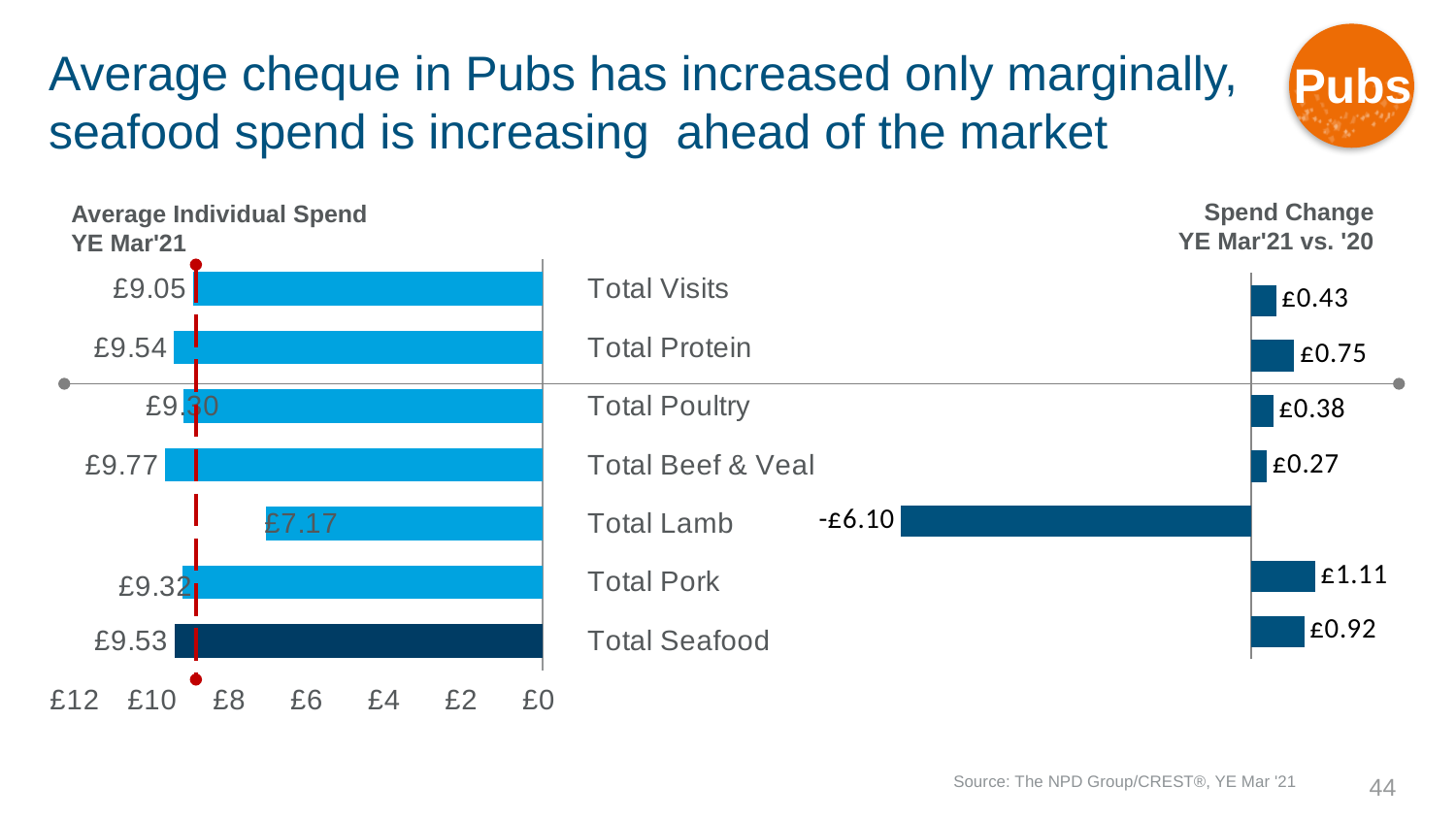
In the Spend Change YE Mar'21 vs. '20 chart, which category has the lowest value? Total Lamb How many categories are shown in the Average Individual Spend YE Mar'21 chart? 7 In the Average Individual Spend YE Mar'21 chart, which category has the lowest value? Total Lamb In the Spend Change YE Mar'21 vs. '20 chart, which is larger, Total Seafood or Total Protein? Total Seafood In the Average Individual Spend YE Mar'21 chart, what is the difference between Total Seafood and Total Visits? £0.48 In the Average Individual Spend YE Mar'21 chart, which category has the highest value? Total Beef & Veal In the Spend Change YE Mar'21 vs. '20 chart, what is the value for Total Pork? £1.11 What kind of chart is the Spend Change YE Mar'21 vs. '20 chart? Bar chart In the Average Individual Spend YE Mar'21 chart, what is the value for Total Lamb? £7.17 In the Spend Change YE Mar'21 vs. '20 chart, which category has the largest increase? Total Pork In the Spend Change YE Mar'21 vs. '20 chart, what is the value for Total Lamb? -£6.10 In the Average Individual Spend YE Mar'21 chart, what is the value for Total Seafood? £9.53